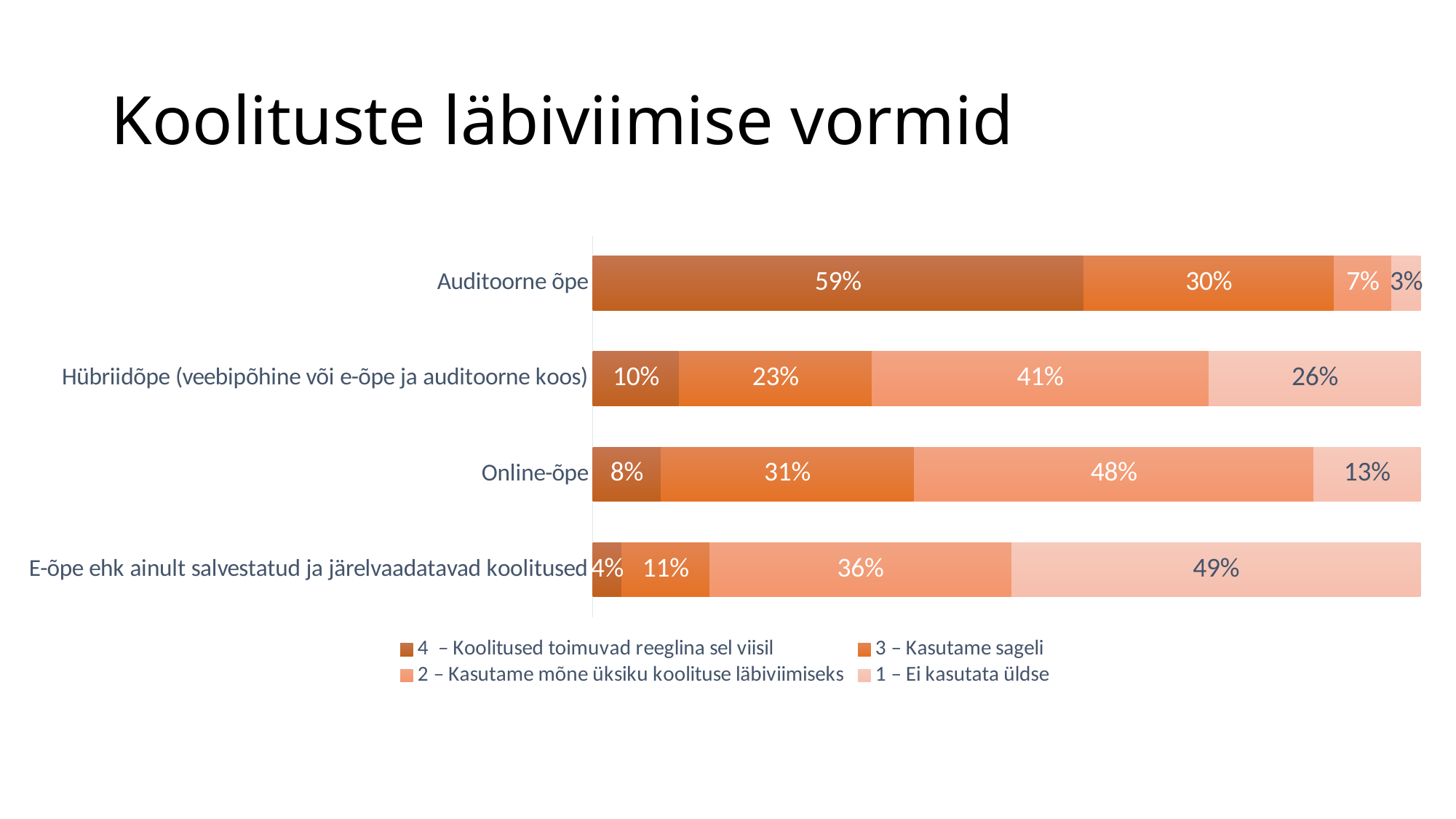
Which category has the lowest value for "1 – Ei kasutata üldse"? Auditoorne õpe How many categories (training forms) are shown in the chart? 4 Which has the larger "1 – Ei kasutata üldse" value: Hübriidõpe (veebipõhine või e-õpe ja auditoorne koos) or Online-õpe? Hübriidõpe (veebipõhine või e-õpe ja auditoorne koos) What percentage is shown for "1 – Ei kasutata üldse" in the E-õpe ehk ainult salvestatud ja järelvaadatavad koolitused bar? 49% What percentage is shown for "4 – Koolitused toimuvad reeglina sel viisil" in the Auditoorne õpe bar? 59% How much larger is the "2 – Kasutame mõne üksiku koolituse läbiviimiseks" value for Online-õpe than for Hübriidõpe (veebipõhine või e-õpe ja auditoorne koos)? 7% How many series does the legend list? 4 What percentage is shown for "2 – Kasutame mõne üksiku koolituse läbiviimiseks" in the Hübriidõpe (veebipõhine või e-õpe ja auditoorne koos) bar? 41% What is the total of the four segments in the Online-õpe bar? 100% What kind of chart is shown on the slide? Stacked bar chart What percentage is shown for "3 – Kasutame sageli" in the Online-õpe bar? 31% Which category has the highest value for "4 – Koolitused toimuvad reeglina sel viisil"? Auditoorne õpe